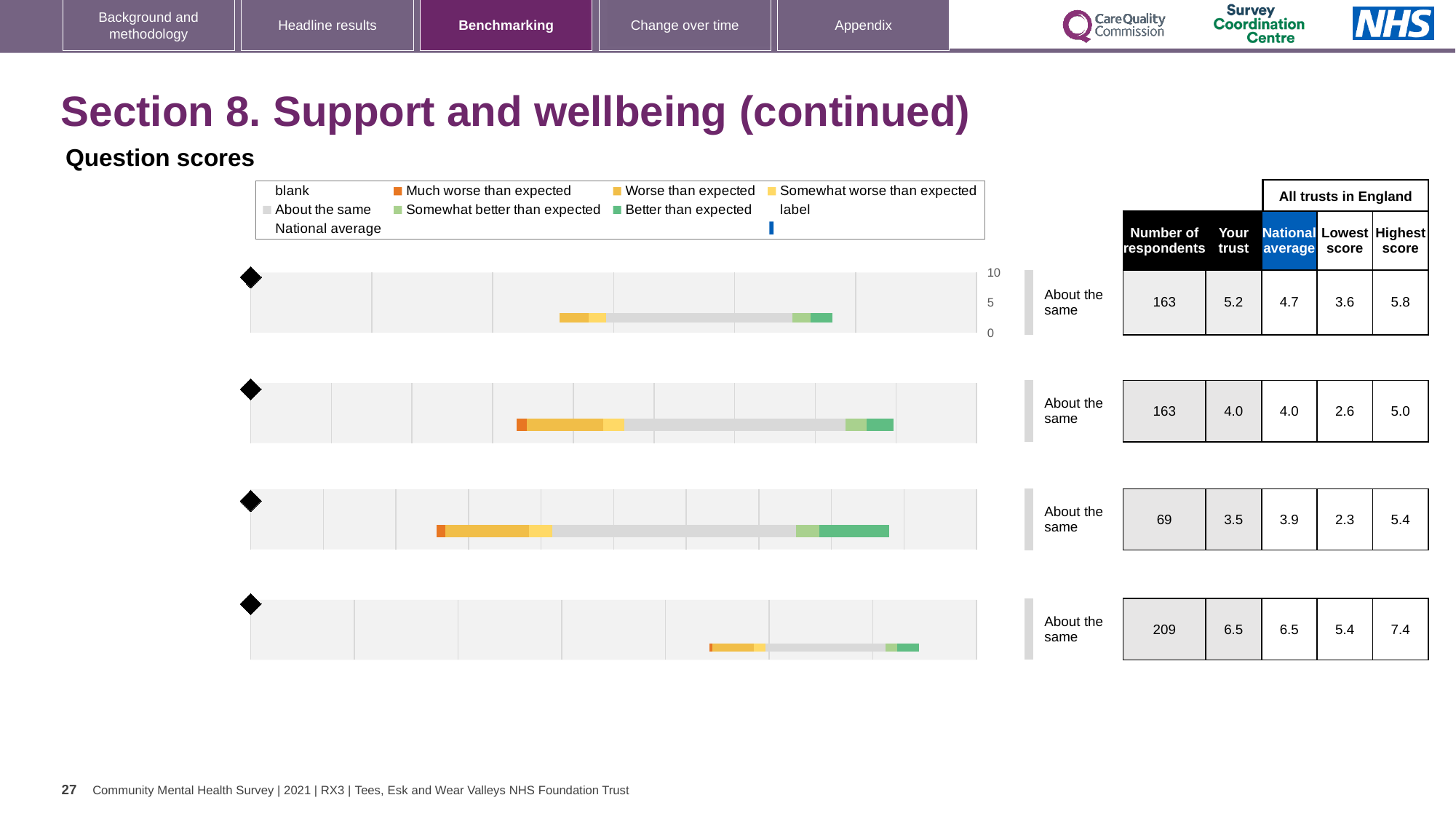
For the second chart from the top, what is the lowest score among all trusts in England? 2.6 Which chart has the highest 'Your trust' score? the fourth (bottom) chart For the fourth (bottom) chart, what is the difference between the highest score and the lowest score? 2.0 What kind of chart is used on this slide to show the question scores? bar chart For the first (top) chart, which is larger: the 'Your trust' score or the national average? Your trust In the legend, which colour represents 'Much worse than expected'? orange For the third chart from the top, what is the difference between the national average and the 'Your trust' score? 0.4 How many question score charts are shown on the slide? 4 For the first (top) chart, what is the national average score? 4.7 For the third chart from the top, how many respondents are listed? 69 Which chart has the lowest number of respondents? the third chart For the first (top) chart, what is the 'Your trust' score shown in the table? 5.2